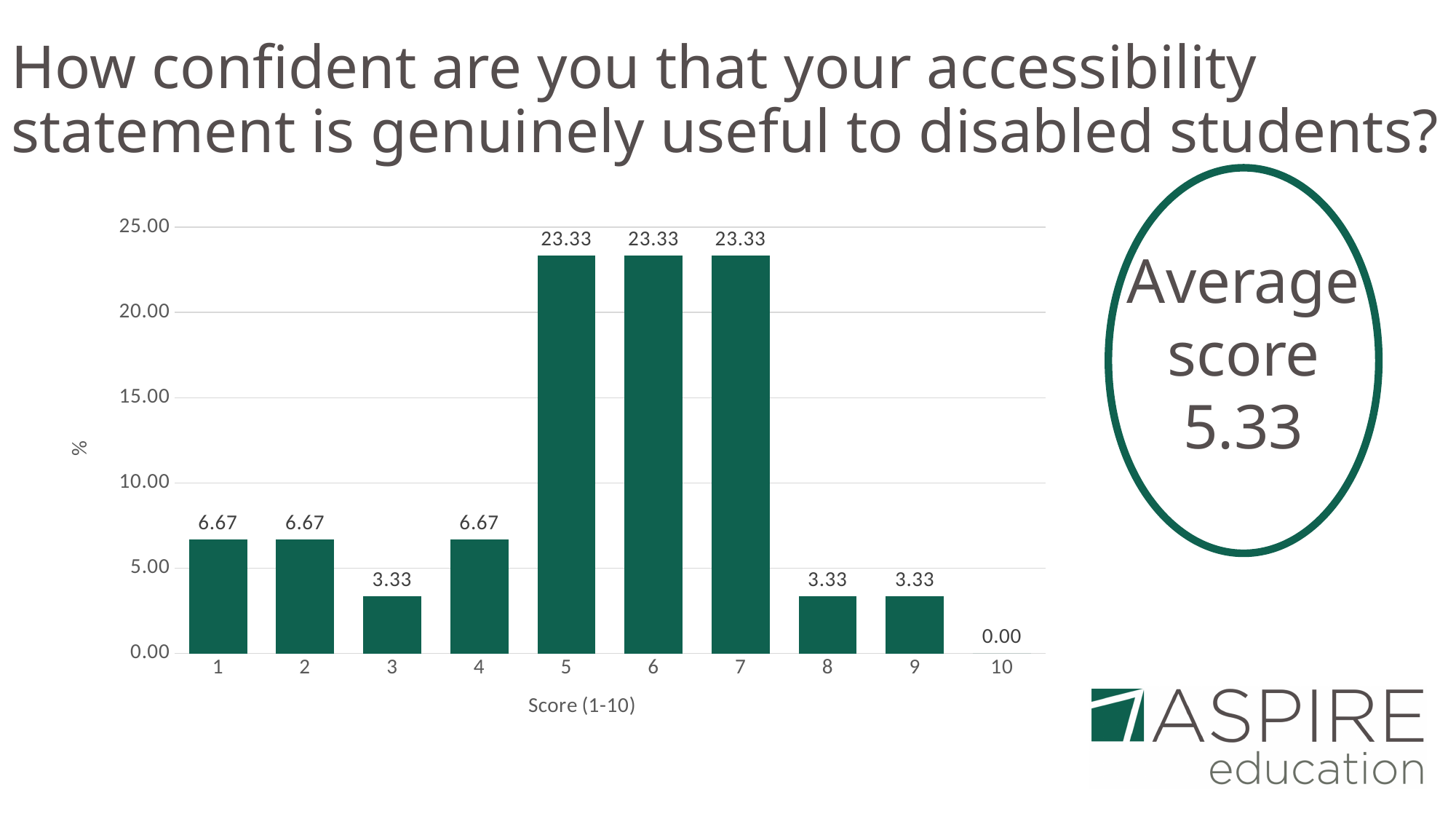
Which score has the lowest percentage of respondents? 10 What average score is shown in the circle on the slide? 5.33 How many score categories are shown on the x axis? 10 What percentage of respondents gave a score of 1? 6.67 Which has a higher percentage of respondents, score 2 or score 9? Score 2 What percentage of respondents gave a score of 10? 0.00 Is the value for score 6 greater or less than 20.00? greater What kind of chart is shown on the slide? Bar chart What percentage of respondents gave a score of 5? 23.33 What is the difference in percentage between score 5 and score 4? 16.66 What is the difference in percentage between score 1 and score 8? 3.34 What percentage of respondents gave a score of 3? 3.33